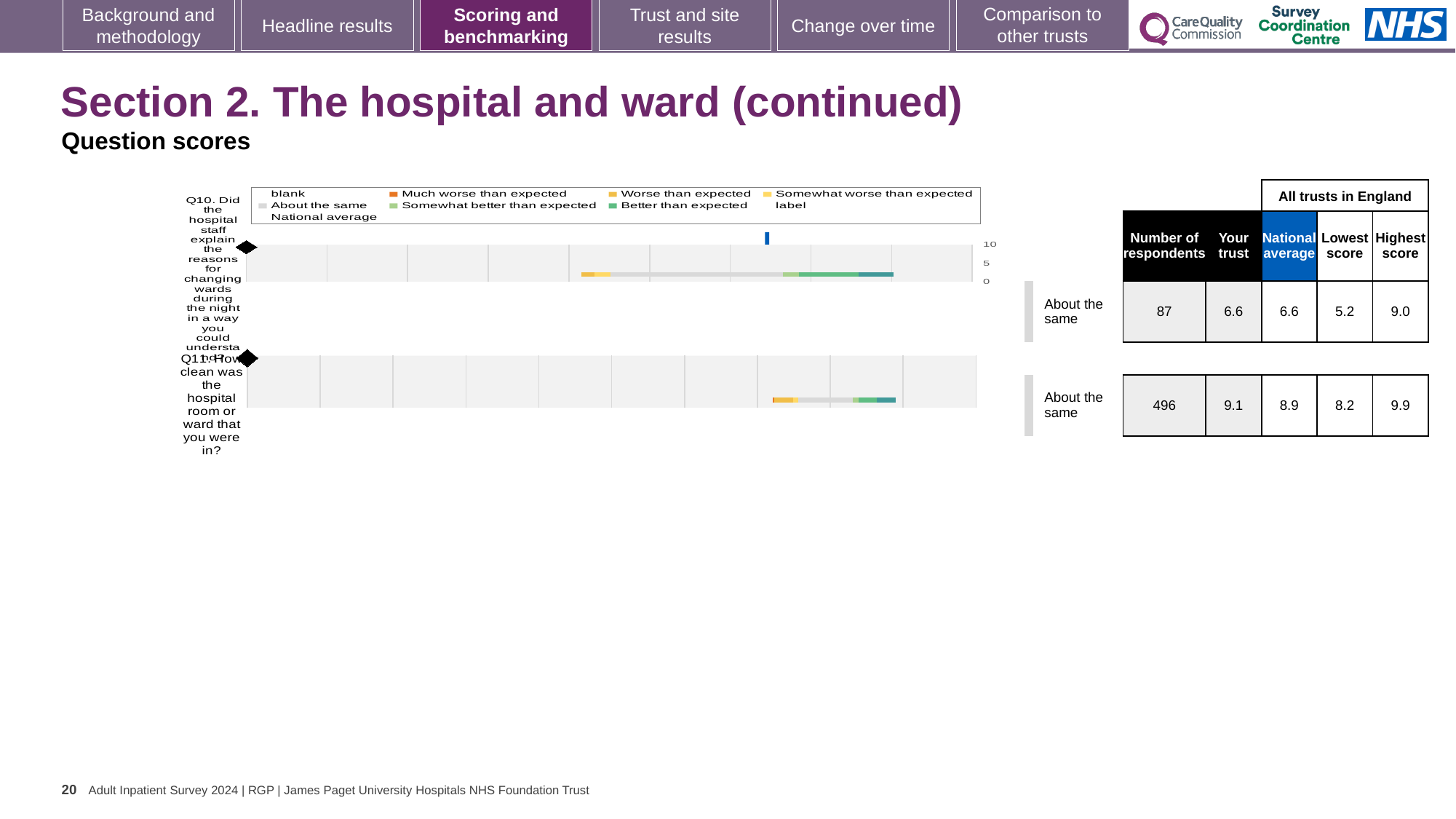
Which question has the higher 'Your trust' score, Q10 or Q11? Q11 How many respondents answered Q11? 496 What is the national average score for Q11? 8.9 What benchmark category is shown for Q10? About the same For Q11, what is the difference between the 'Your trust' score and the national average? 0.2 For Q11 (how clean was the hospital room or ward), what is the 'Your trust' score? 9.1 For Q10 (explaining reasons for changing wards during the night), what is the 'Your trust' score? 6.6 For Q10, what is the difference between the highest score and the lowest score across all trusts in England? 3.8 Is the 'Your trust' score for Q10 greater or less than 5? greater How many respondents answered Q10? 87 What kind of chart is used to show the question scores for Q10 and Q11? bar chart How many questions are charted on this slide? 2